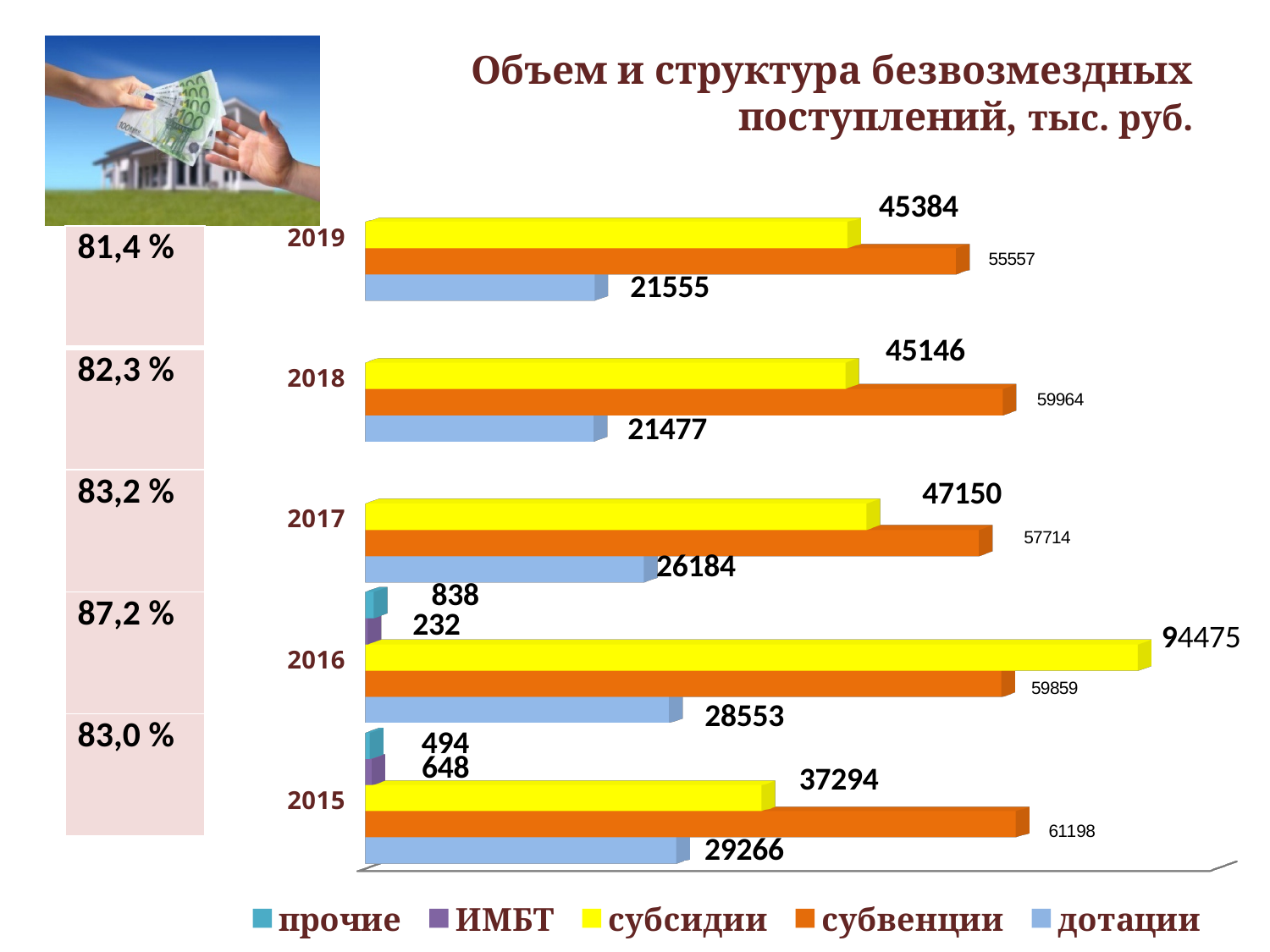
Which is larger in 2015: субсидии or субвенции? субвенции In which year is the value of дотации the lowest? 2018 How many series does the legend list? 5 What is the difference between субвенции and субсидии in 2019? 10173 What kind of chart is shown on the slide? bar chart What is the value of субвенции for 2018? 59964 In which year is the value of субсидии the highest? 2016 What is the value of дотации for 2017? 26184 How many years are shown on the chart? 5 What is the value of ИМБТ for 2016? 232 What is the value of субсидии for 2019? 45384 What is the value of прочие for 2015? 494